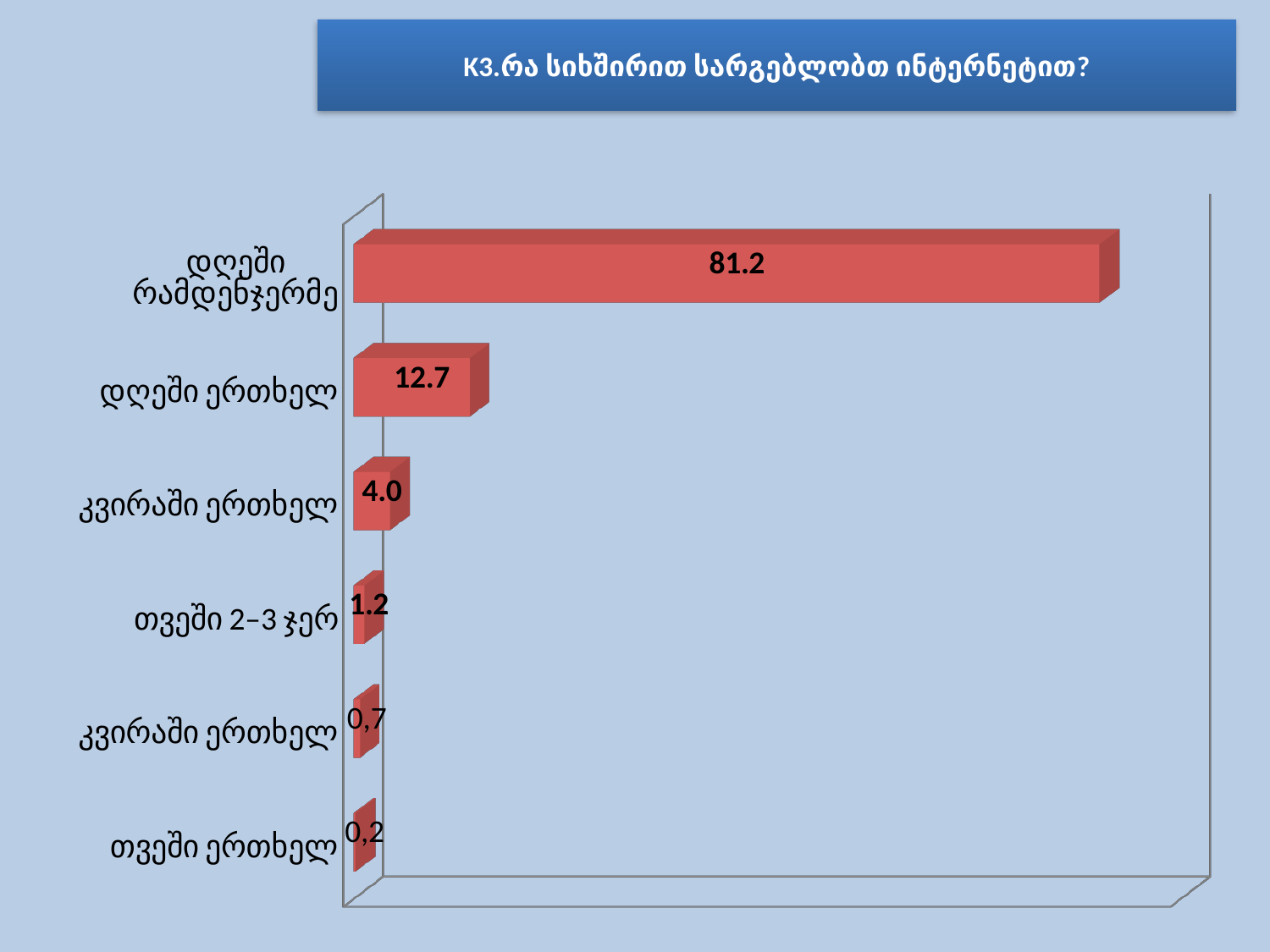
Which category has the highest value? დღეში რამდენჯერმე What is the value of the third bar from the top? 4.0 Which category has the lowest value? თვეში ერთხელ What is the value shown for "თვეში 2-3 ჯერ"? 1.2 What is the value shown for "თვეში ერთხელ"? 0,2 What is the difference between the values for "დღეში რამდენჯერმე" and "დღეში ერთხელ"? 68.5 What kind of chart is shown on the slide? Bar chart What is the value shown for "დღეში რამდენჯერმე"? 81.2 How many categories are shown in the chart? 6 Which is larger, the value for "დღეში ერთხელ" or the value for "თვეში 2-3 ჯერ"? დღეში ერთხელ What is the value shown for "დღეში ერთხელ"? 12.7 What is the value of the fifth bar from the top? 0,7